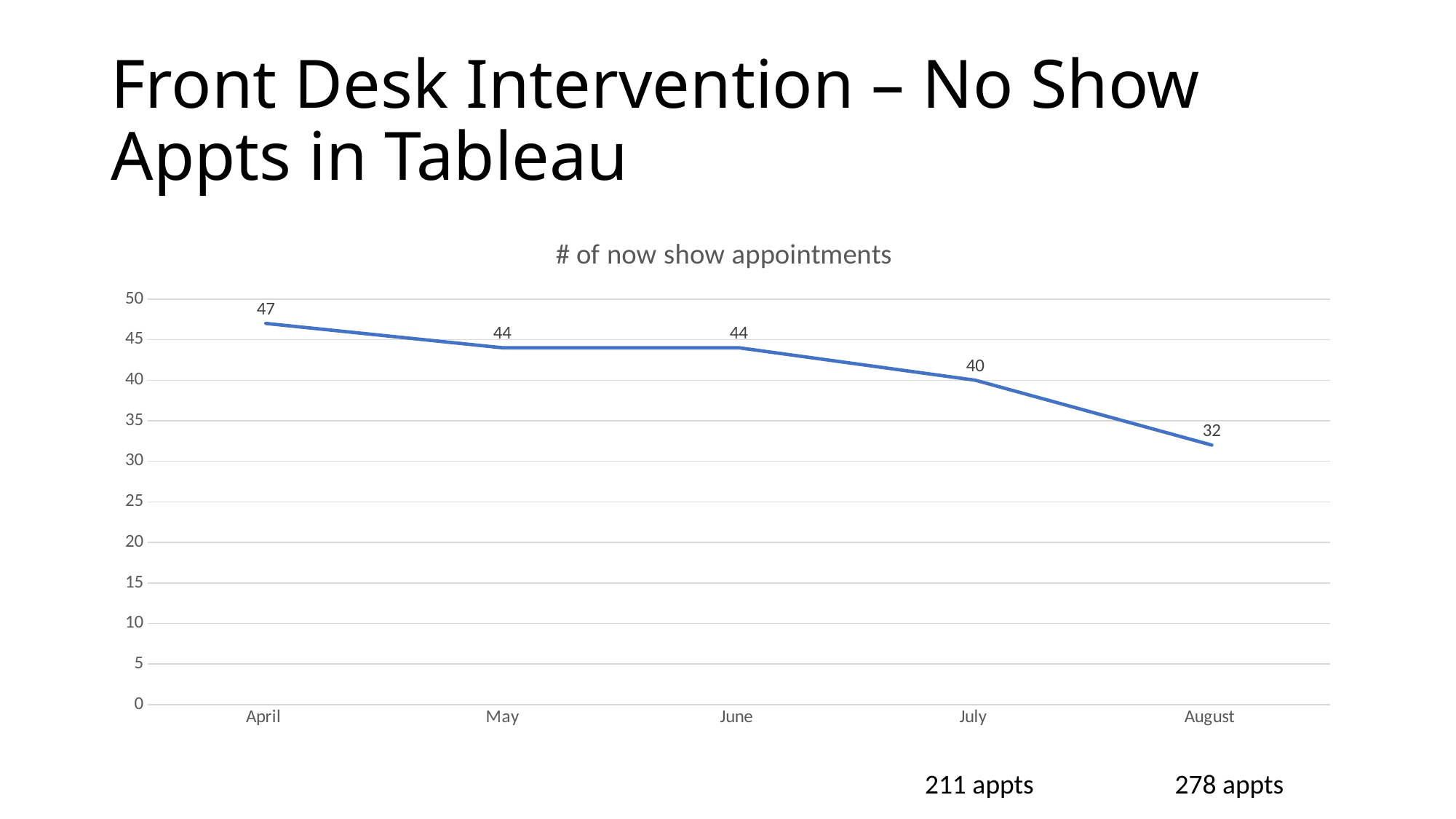
What is the number of no show appointments in April? 47 Which month has the lowest number of no show appointments? August What kind of chart is shown on the slide? Line chart What is the difference between the number of no show appointments in June and July? 4 What is the difference between the number of no show appointments in April and August? 15 What is the number of no show appointments in July? 40 What is the number of no show appointments in August? 32 Is the value for July greater or less than 35? greater How many months are plotted on the chart? 5 Which month has the highest number of no show appointments? April Which month has more no show appointments, May or August? May Do the values rise or fall from April to August? Fall